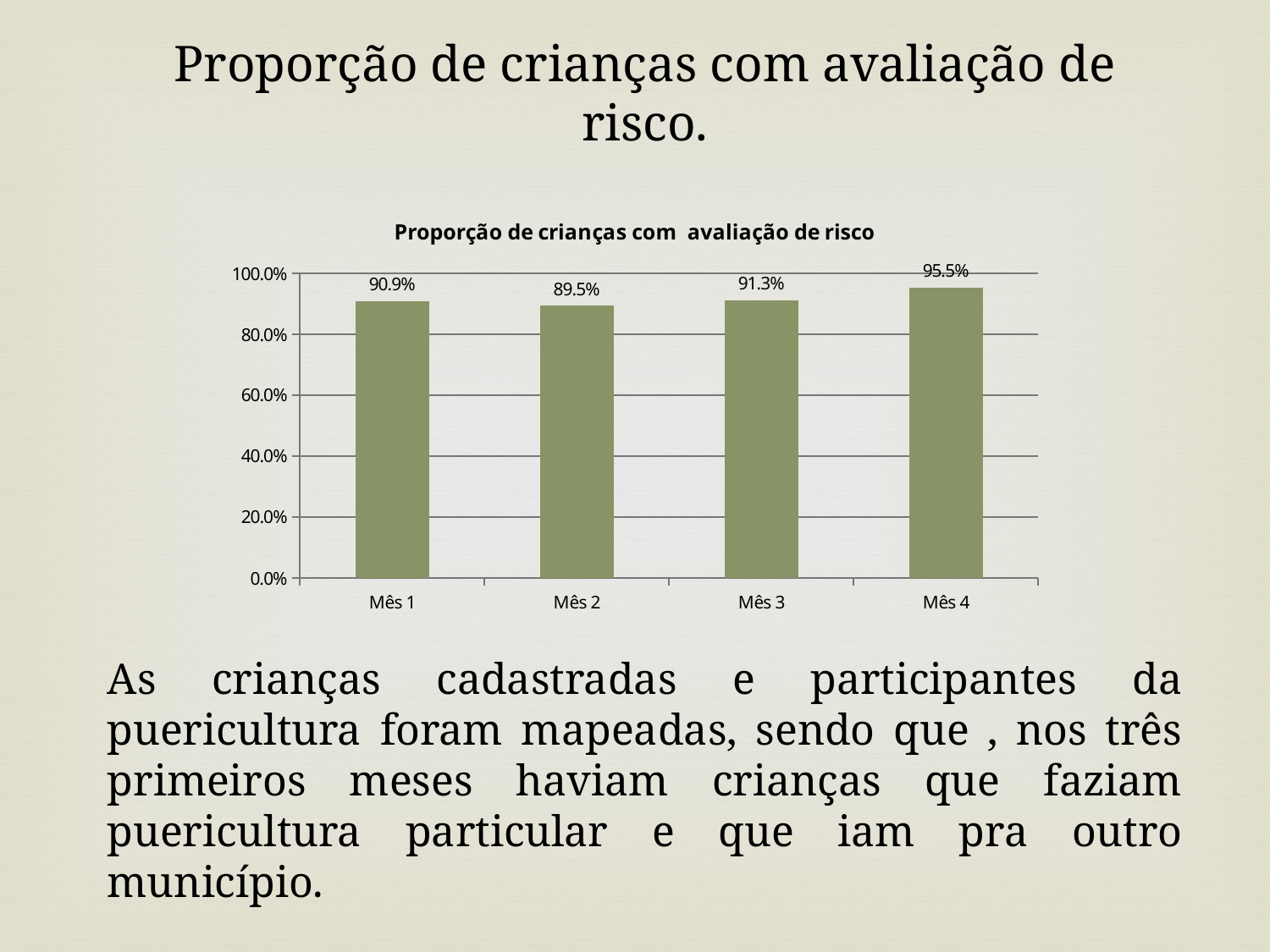
What is the value for Mês 2? 89.5% What kind of chart is shown on the slide? bar chart What is the difference between the values for Mês 4 and Mês 2? 6.0% Which month has the highest value? Mês 4 What is the title of the chart? Proporção de crianças com avaliação de risco Which month has the lowest value? Mês 2 Which is larger, the value for Mês 3 or the value for Mês 2? Mês 3 How many months are shown on the chart? 4 Is the value for Mês 4 greater or less than 80.0%? greater What is the value for Mês 1? 90.9% What is the value for Mês 4? 95.5% What is the value for Mês 3? 91.3%